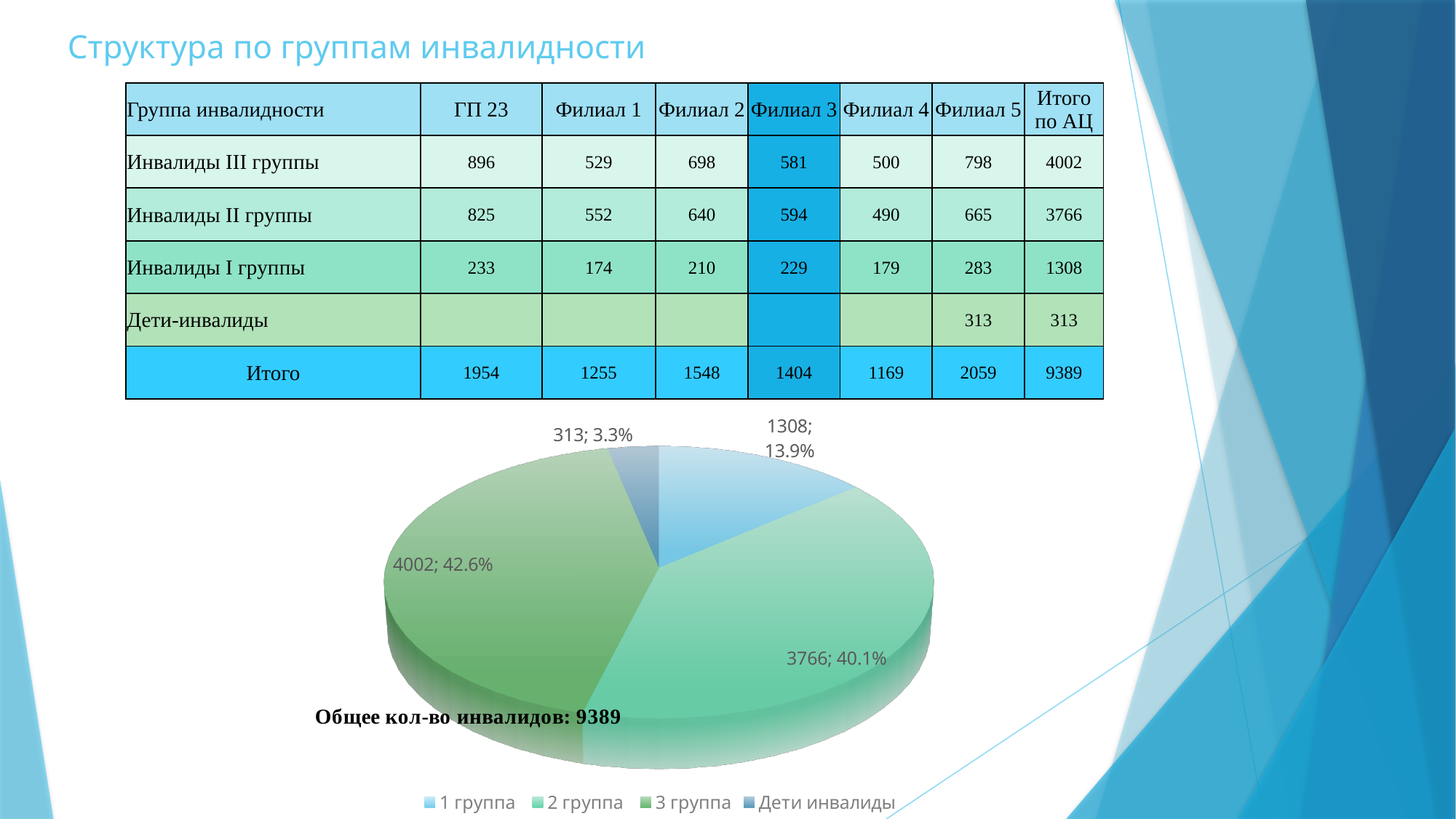
How many entries does the pie chart's legend list? 4 What value is shown for the "Дети инвалиды" slice of the pie chart? 313 What kind of chart is shown on the slide? pie chart Which is larger in the pie chart, the "1 группа" slice or the "Дети инвалиды" slice? 1 группа Which slice of the pie chart is the smallest? Дети инвалиды Which slice of the pie chart is the largest? 3 группа What value is shown for the "1 группа" slice of the pie chart? 1308 What percentage share does the "Дети инвалиды" slice have in the pie chart? 3.3% What value is shown for the "3 группа" slice of the pie chart? 4002 How many slices does the pie chart have? 4 What is the difference between the values of the "3 группа" and "2 группа" slices in the pie chart? 236 What percentage share does the "2 группа" slice have in the pie chart? 40.1%